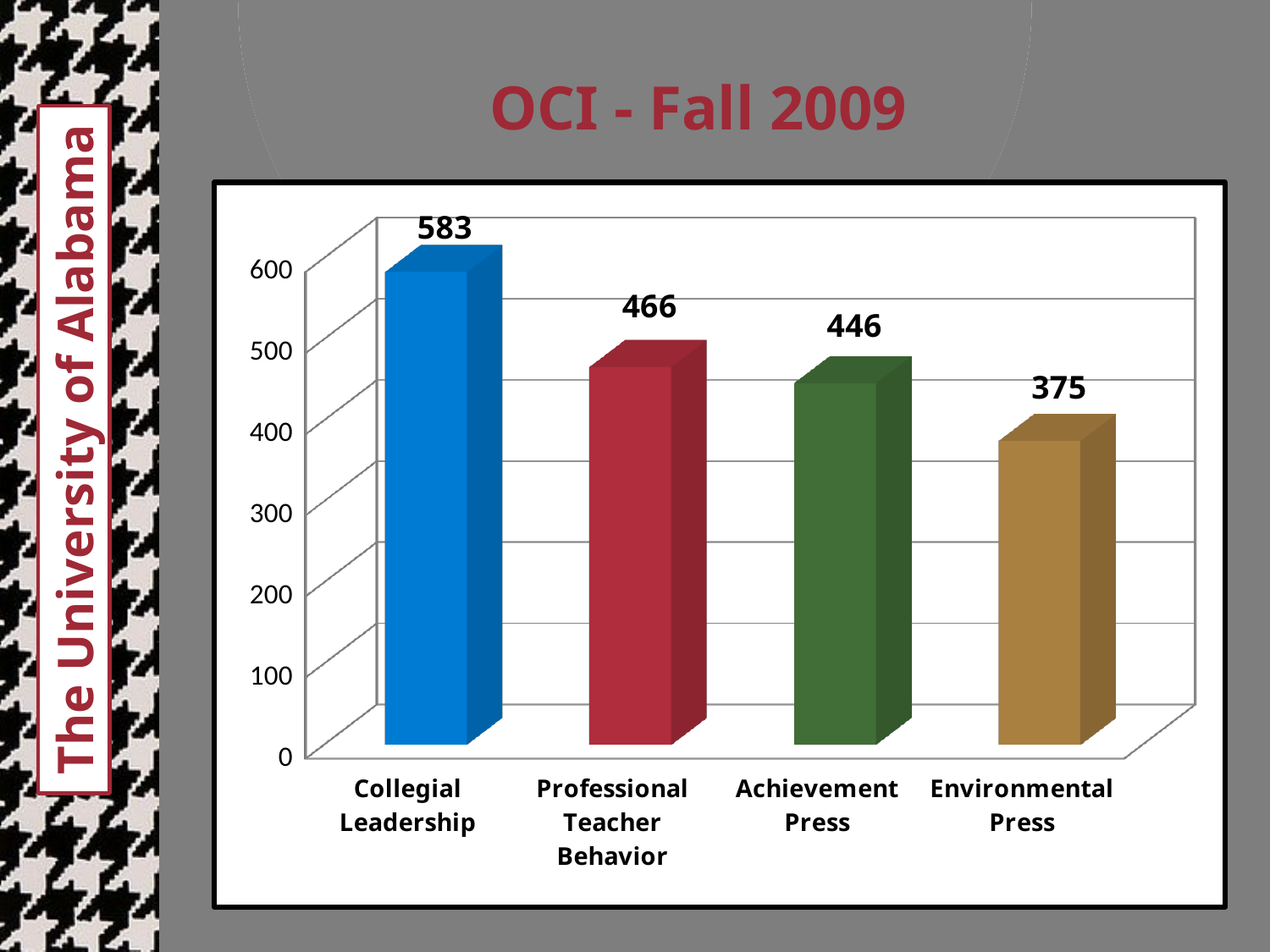
Which is larger, the value for Achievement Press or the value for Environmental Press? Achievement Press What is the value for Collegial Leadership? 583 How many categories are shown in the chart? 4 Is the value for Environmental Press greater or less than 400? less Which category has the lowest value? Environmental Press Which category has the highest value? Collegial Leadership What is the difference between the values for Professional Teacher Behavior and Achievement Press? 20 What is the value for Achievement Press? 446 What is the difference between the values for Collegial Leadership and Environmental Press? 208 What kind of chart is shown on the slide? bar chart What is the value for Professional Teacher Behavior? 466 What is the value for Environmental Press? 375